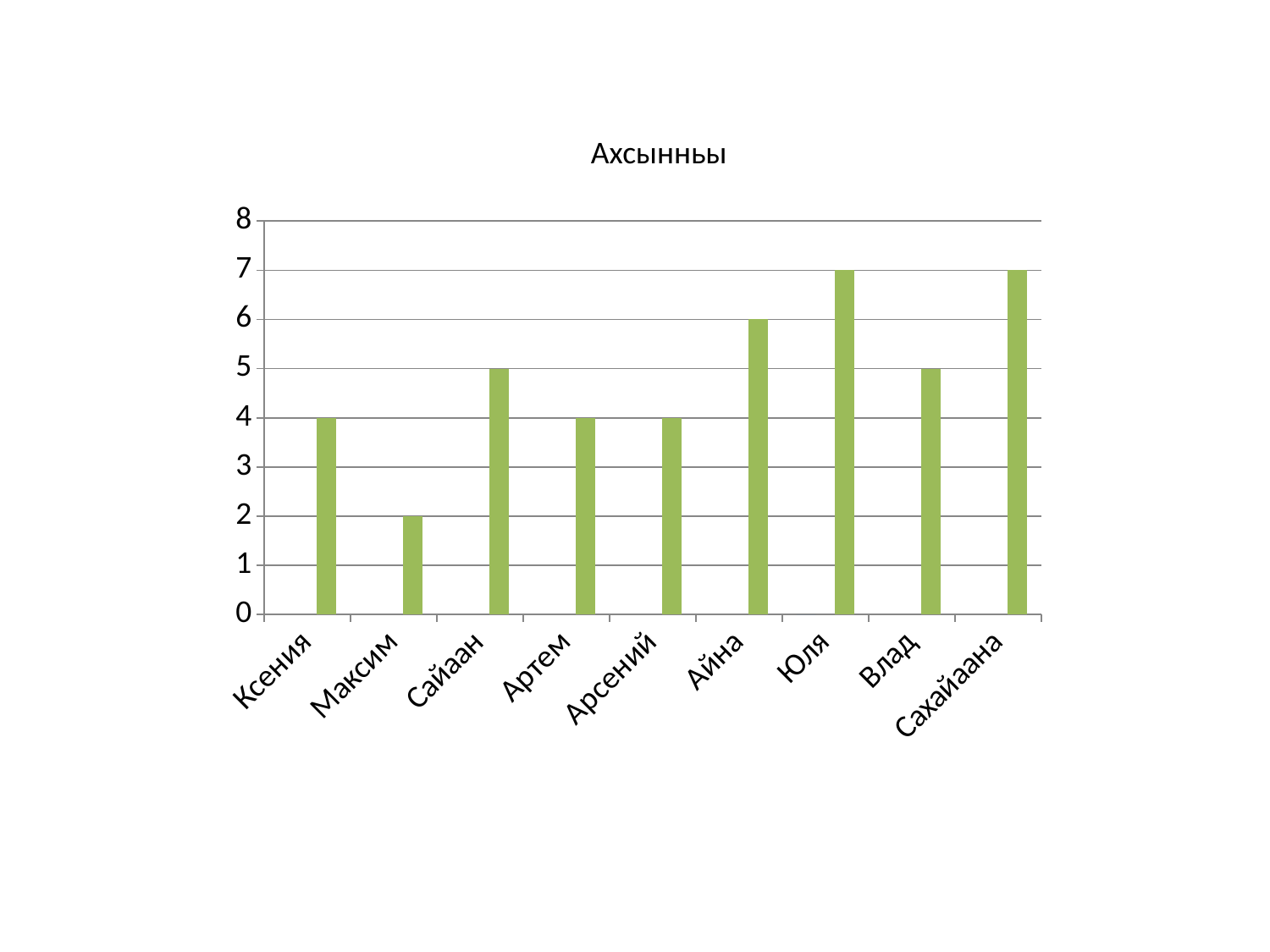
What is the title of the chart? Ахсынньы Is the value for Сахайаана greater or less than 5? greater What is the difference between the values for Айна and Ксения? 2 What is the difference between the values for Юля and Максим? 5 How many categories are shown on the x axis? 9 Which is larger, the value for Влад or the value for Артем? Влад Which category has the lowest value? Максим What is the value for Айна? 6 What is the value for Сайаан? 5 What kind of chart is shown on the slide? bar chart What is the value for Максим? 2 What is the value for Юля? 7